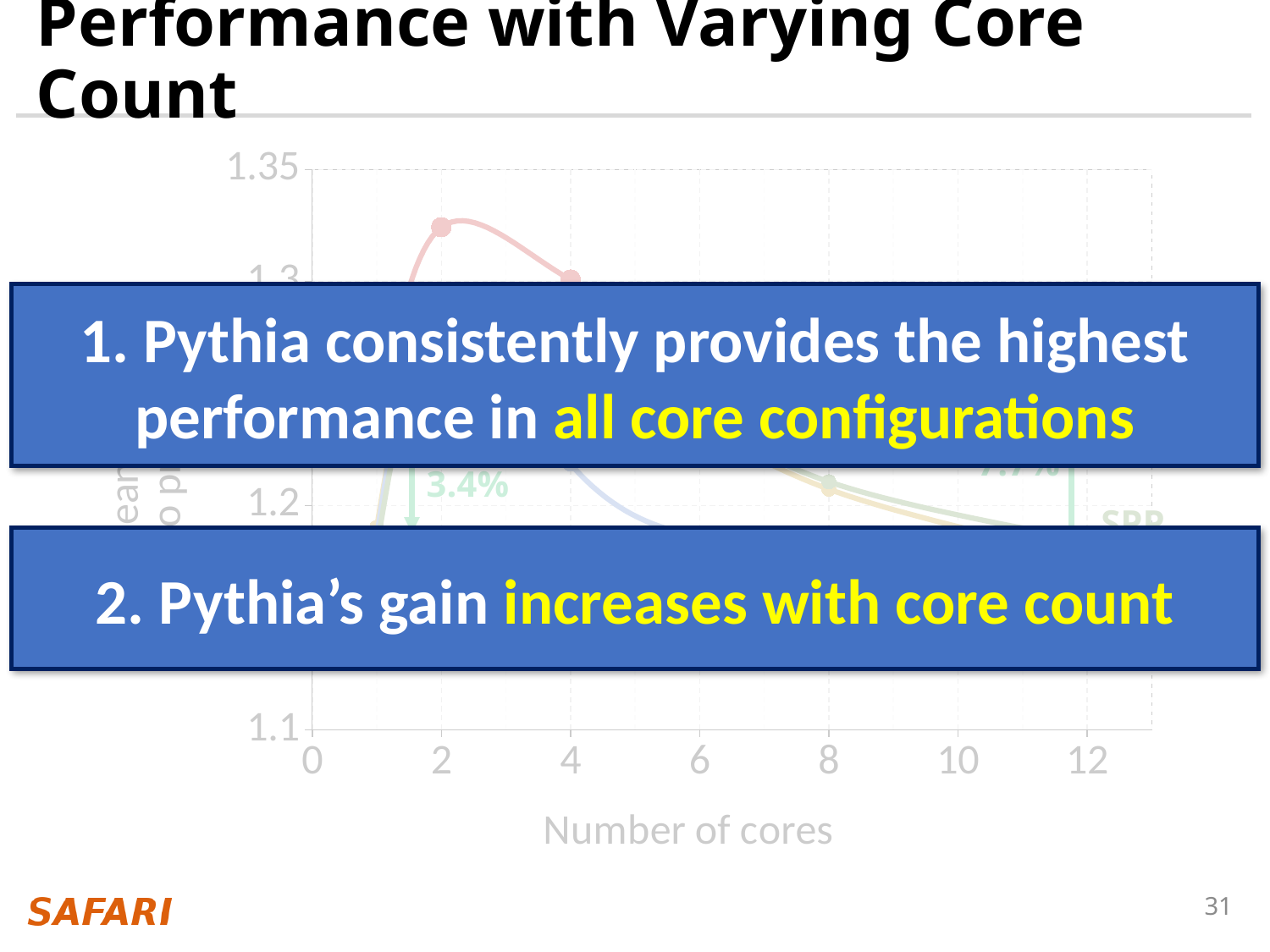
What is the highest value shown on the y axis of the chart? 1.35 What is the label of the x axis of the chart? Number of cores Is the value of the red line at 2 cores greater or less than 1.3? greater What kind of chart is shown on the slide? line chart